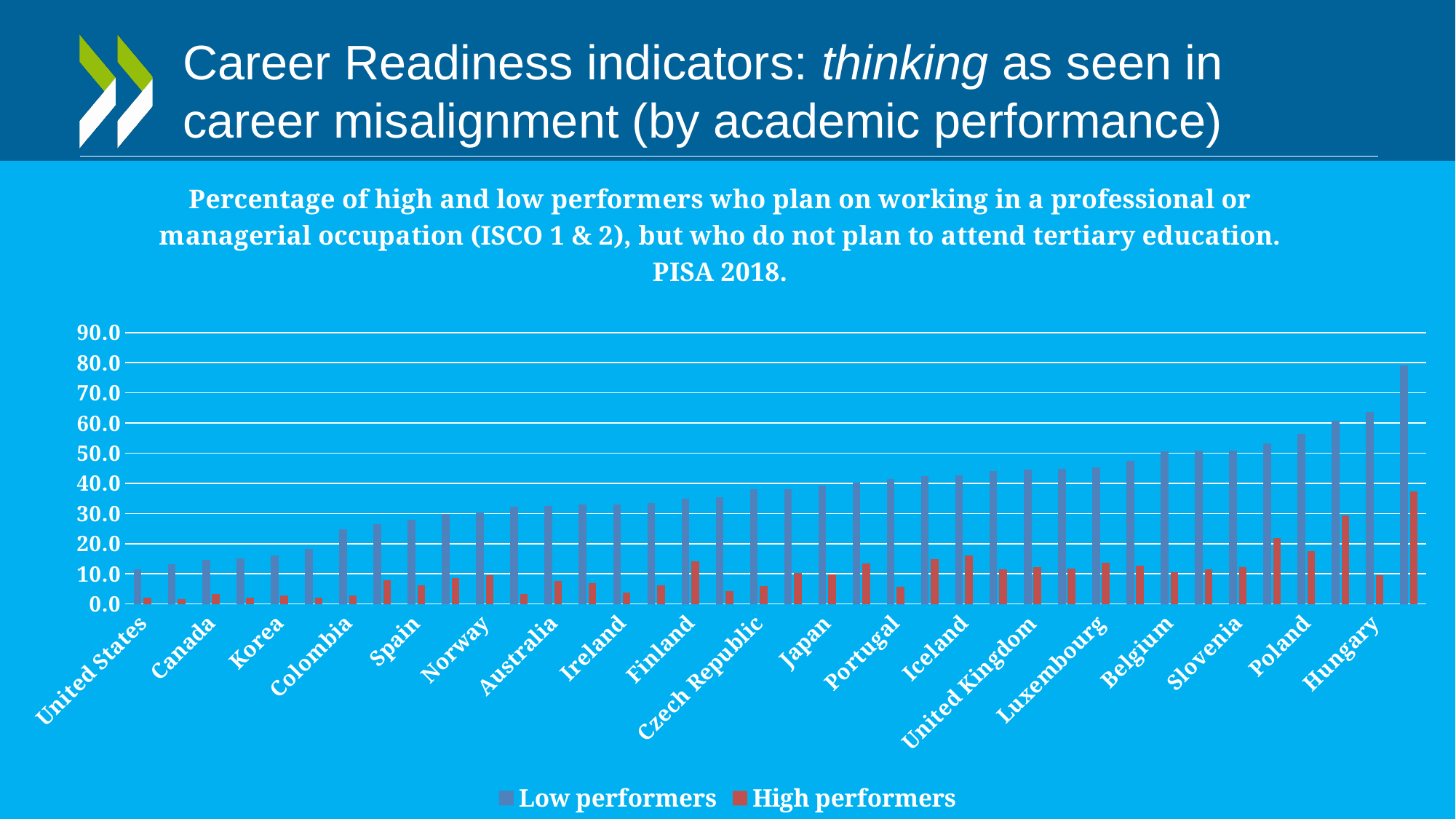
What kind of chart is shown on the slide? bar chart Is the High performers value for Hungary greater or less than 30? less Is the Low performers value for Hungary greater or less than 70? less Which country has the lowest value for Low performers? United States What are the two series named in the legend? Low performers and High performers Which is larger for Hungary: the Low performers value or the High performers value? Low performers Which colour represents High performers in the chart? red Is the High performers value for the United States greater or less than 10? less Do the Low performers values rise or fall moving from left to right along the x axis? rise How many series does the legend list? 2